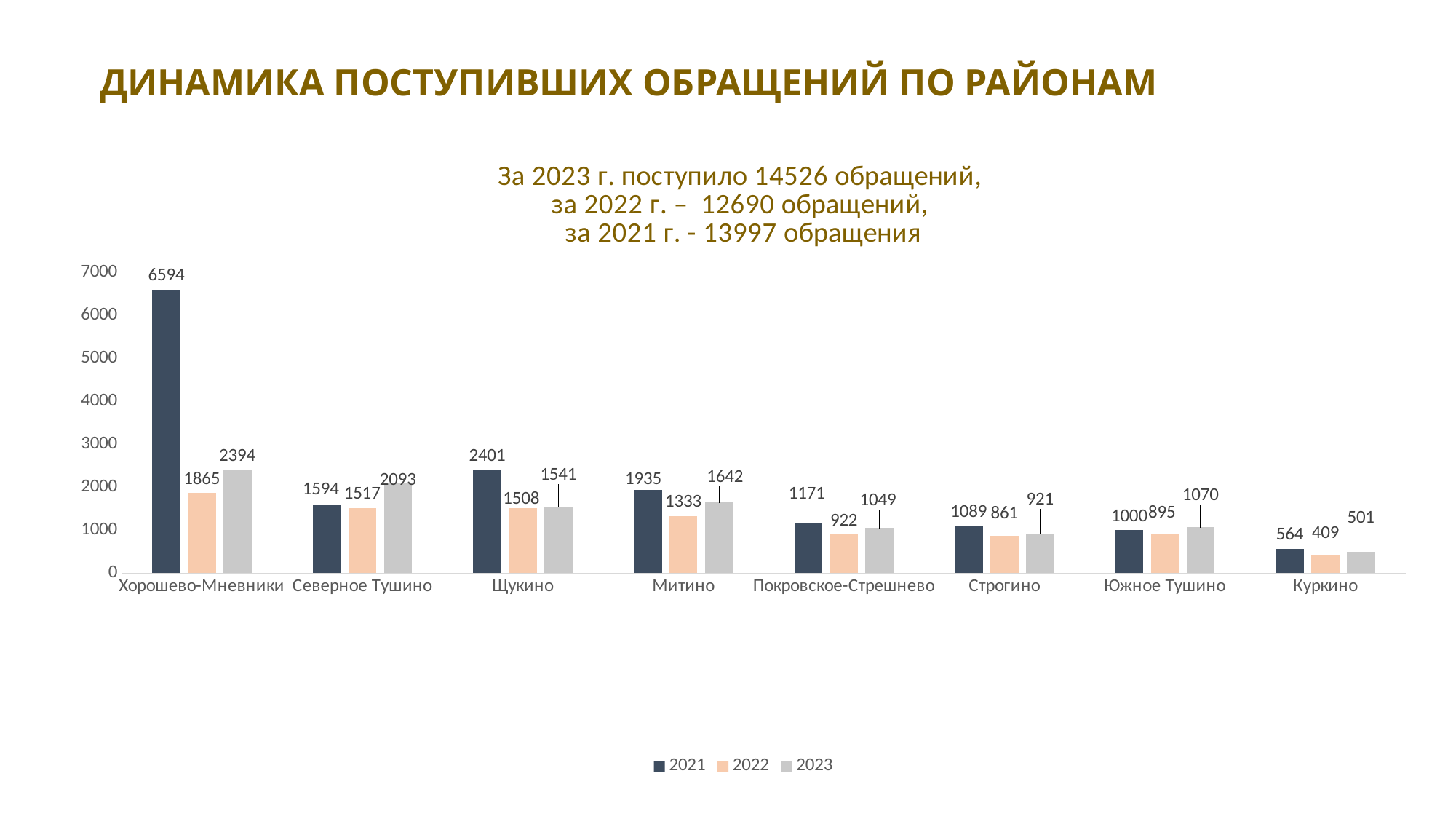
What is the value for Щукино in the 2023 series? 1541 How many series does the legend list? 3 How many districts are shown on the x axis? 8 What is the title of the slide? ДИНАМИКА ПОСТУПИВШИХ ОБРАЩЕНИЙ ПО РАЙОНАМ What is the value for Куркино in the 2022 series? 409 Which district has the highest value in the 2021 series? Хорошево-Мневники What is the value for Хорошево-Мневники in the 2021 series? 6594 What is the difference between the 2021 and 2023 values for Хорошево-Мневники? 4200 Which district has the lowest value in the 2023 series? Куркино What kind of chart is shown on the slide? Bar chart What is the difference between the 2021 and 2022 values for Строгино? 228 Which is larger for Митино: the 2022 value or the 2023 value? 2023